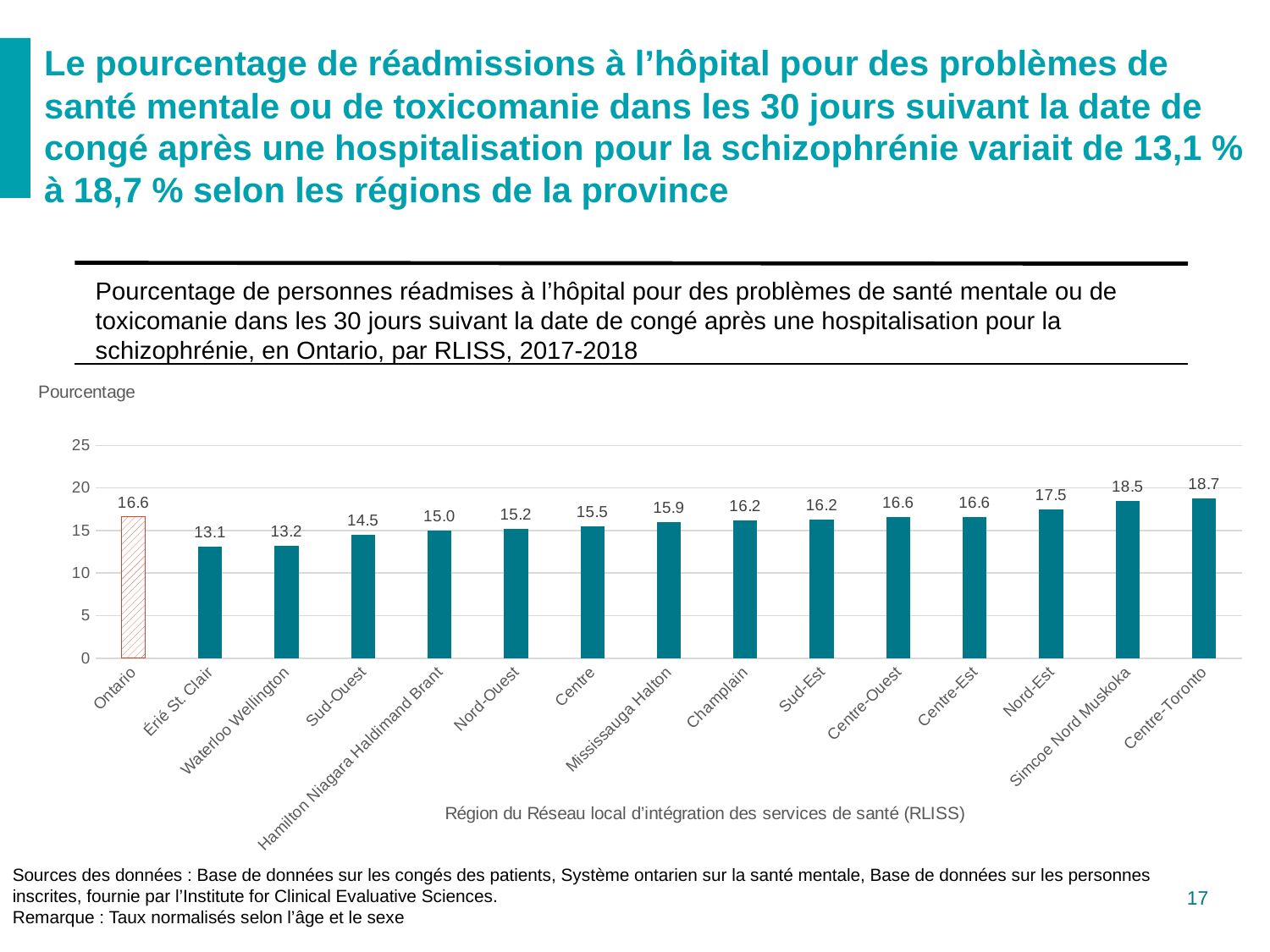
Which region has the highest value? Centre-Toronto What is the difference between the values for Centre-Toronto and Érié St. Clair? 5.6 Which region has the lowest value? Érié St. Clair What is the value for Champlain? 16.2 Do the values for the RLISS regions rise or fall from left to right (excluding Ontario)? rise How many bars are shown in the chart? 15 Which is larger, the value for Nord-Est or the value for Centre? Nord-Est What is the value for Ontario? 16.6 Is the value for Sud-Ouest greater or less than 15? less What is the label of the y axis? Pourcentage What is the value for Simcoe Nord Muskoka? 18.5 What kind of chart is this? bar chart